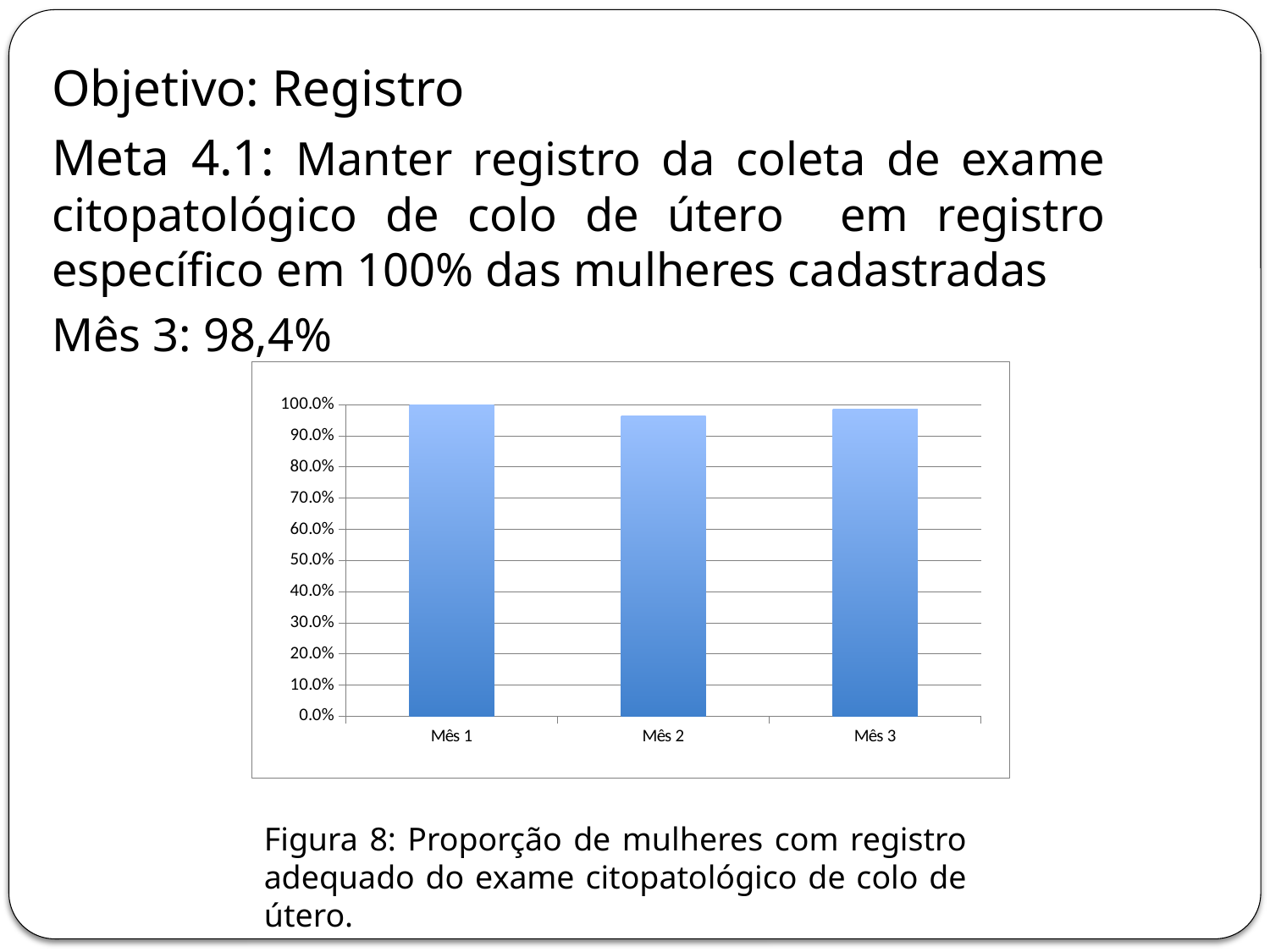
Which bar is taller, Mês 2 or Mês 3? Mês 3 How many bars (categories) does the chart show? 3 Which bar is taller, Mês 1 or Mês 2? Mês 1 What figure number is given in the caption below the chart? Figura 8 According to the slide text, what is the value for Mês 3? 98,4% Is the value for Mês 2 greater or less than 90.0%? greater What is the highest value shown on the chart's vertical axis? 100.0% What kind of chart is shown on the slide? bar chart Is the value for Mês 3 greater or less than 90.0%? greater Is the value for Mês 1 greater or less than 80.0%? greater Which month has the lowest bar in the chart? Mês 2